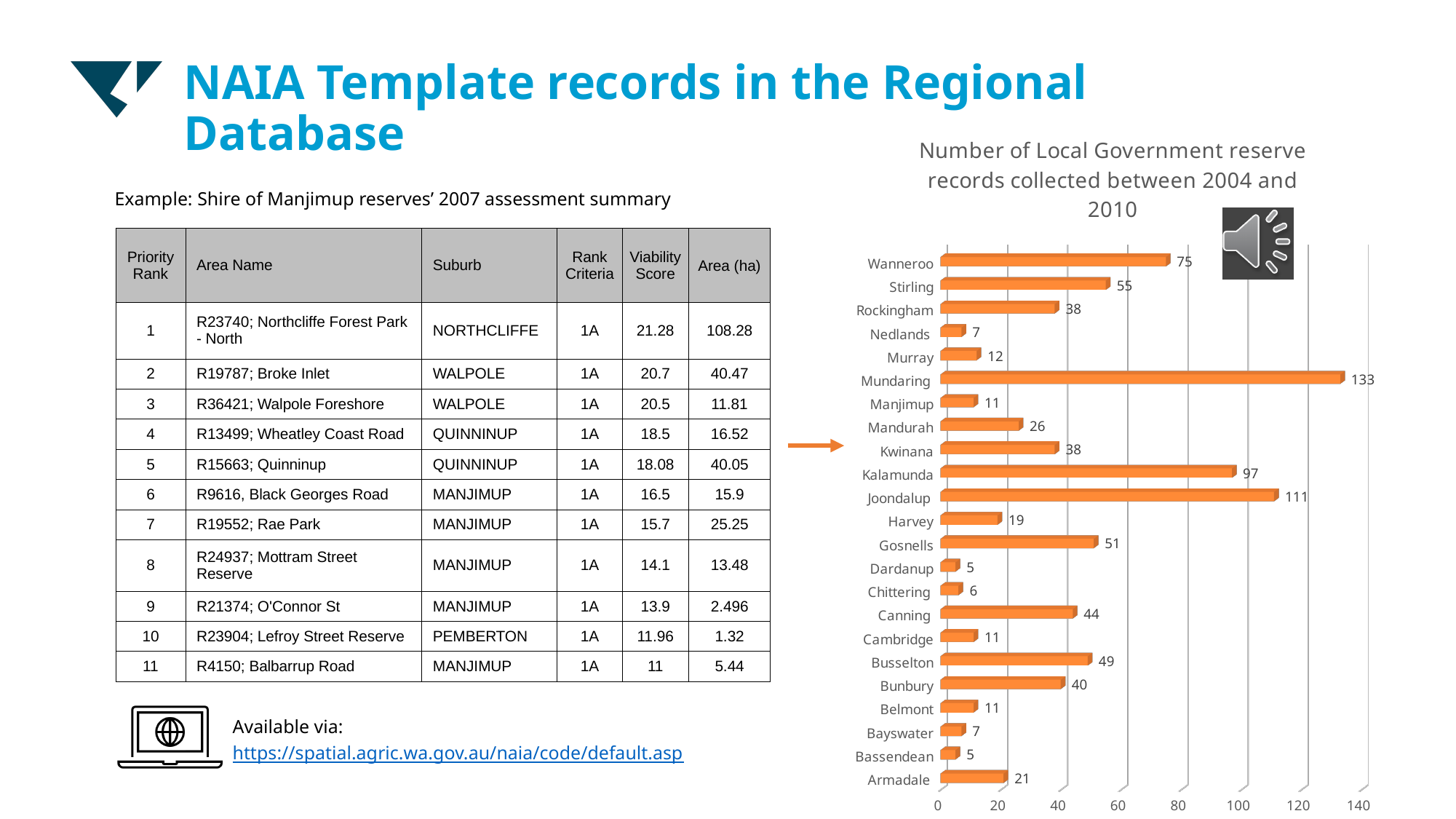
What is the title of the chart? Number of Local Government reserve records collected between 2004 and 2010 Is the value for Kalamunda greater or less than 80? greater How many reserve records does the chart show for Kalamunda? 97 What is the value for Mundaring in the chart? 133 What is the difference between the values for Busselton and Bunbury? 9 What is the value for Manjimup in the chart? 11 Which has a larger value, Canning or Mandurah? Canning What is the difference between the values for Joondalup and Wanneroo? 36 How many local governments are listed in the chart? 23 Which local government has the highest number of reserve records in the chart? Mundaring Which has a larger value, Stirling or Gosnells? Stirling What kind of chart is shown on the slide? Bar chart